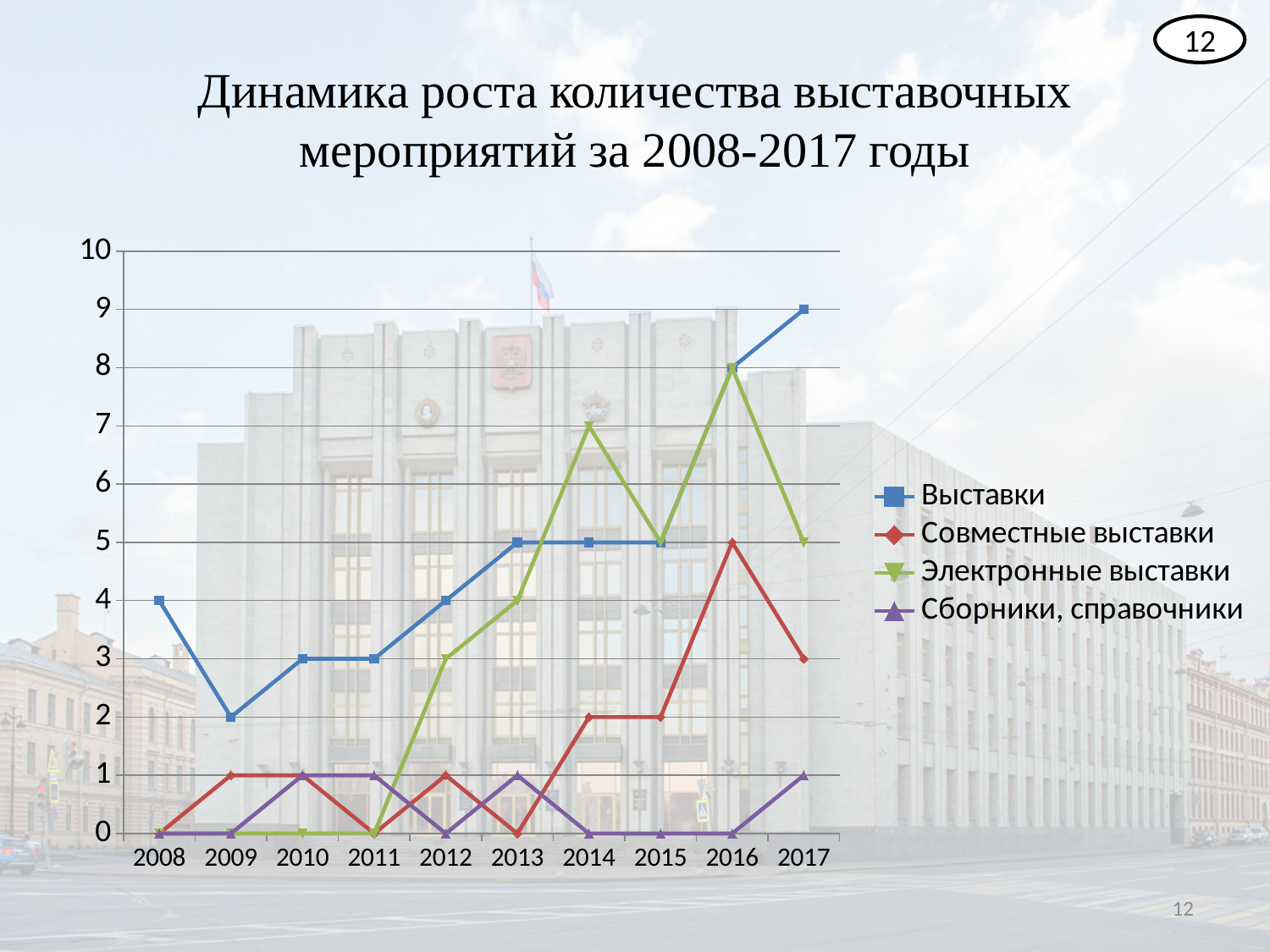
How many series does the legend list? 4 What is the value for Совместные выставки in 2016? 5 What is the value for Выставки in 2017? 9 How many years are shown on the x axis? 10 What kind of chart is shown on the slide? line chart In which year does the Выставки series reach its highest value? 2017 Does the Электронные выставки series rise or fall from 2011 to 2014? rise What is the value for Электронные выставки in 2014? 7 What is the title of the chart? Динамика роста количества выставочных мероприятий за 2008-2017 годы What is the difference between Выставки in 2017 and Выставки in 2008? 5 In which year does the Выставки series have its lowest value? 2009 Which is larger in 2016: Выставки or Совместные выставки? Выставки